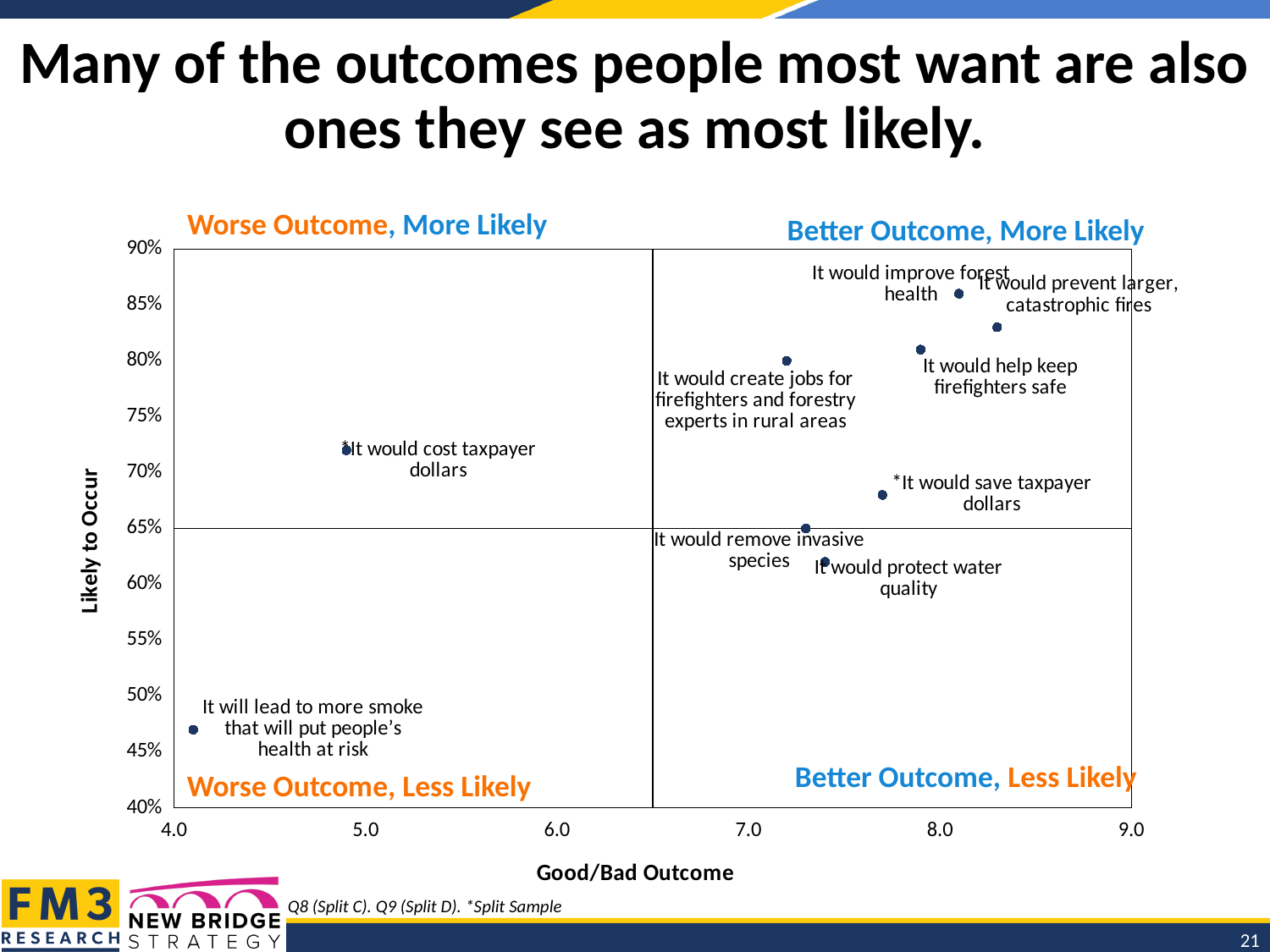
Which outcome has the highest value on the 'Likely to Occur' axis? It would improve forest health How many data points are plotted on the chart? 9 Which outcome has the lowest value on the 'Likely to Occur' axis? It will lead to more smoke that will put people's health at risk Is the 'Likely to Occur' value for 'It will lead to more smoke that will put people's health at risk' greater or less than 50%? less Which has a higher 'Likely to Occur' value: 'It would help keep firefighters safe' or 'It would save taxpayer dollars'? It would help keep firefighters safe What kind of chart is shown on the slide? Scatter chart Is the 'Likely to Occur' value for 'It would cost taxpayer dollars' greater or less than 75%? less Is the 'Likely to Occur' value for 'It would protect water quality' greater or less than 65%? less What label is shown in the upper-right quadrant of the chart? Better Outcome, More Likely What is the title of the vertical axis? Likely to Occur Which outcome has the lowest value on the 'Good/Bad Outcome' axis? It will lead to more smoke that will put people's health at risk